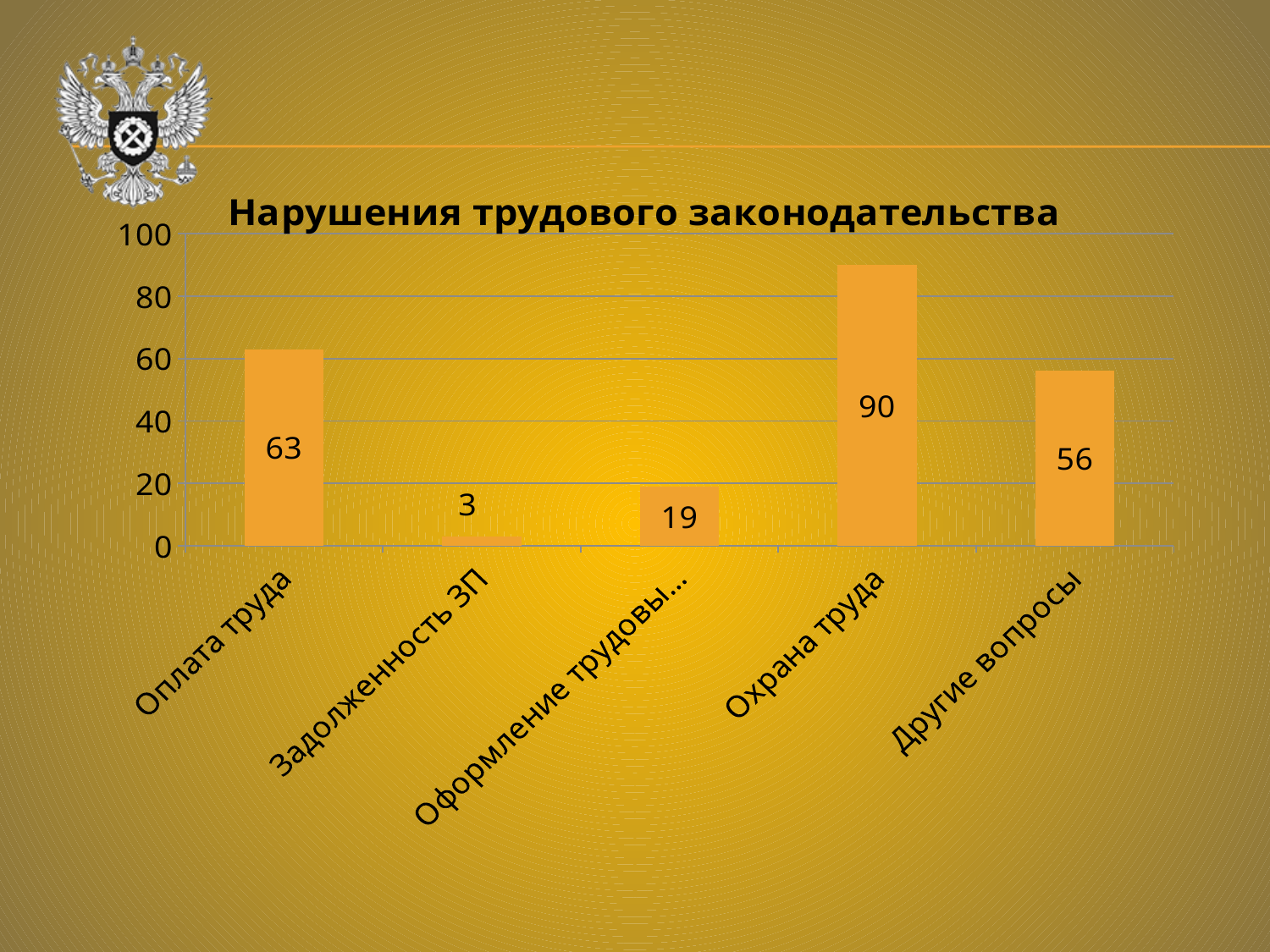
What is the value for Задолженность ЗП? 3 Is the value for Охрана труда greater or less than 80? greater What is the value for Оплата труда? 63 What kind of chart is shown on the slide? bar chart What is the title of the chart? Нарушения трудового законодательства What is the difference between the values for Охрана труда and Оплата труда? 27 What is the value for Охрана труда? 90 Which category has the lowest value? Задолженность ЗП Which category has the highest value? Охрана труда Which is larger, the value for Оплата труда or the value for Другие вопросы? Оплата труда How many categories are shown in the chart? 5 What is the value for Другие вопросы? 56